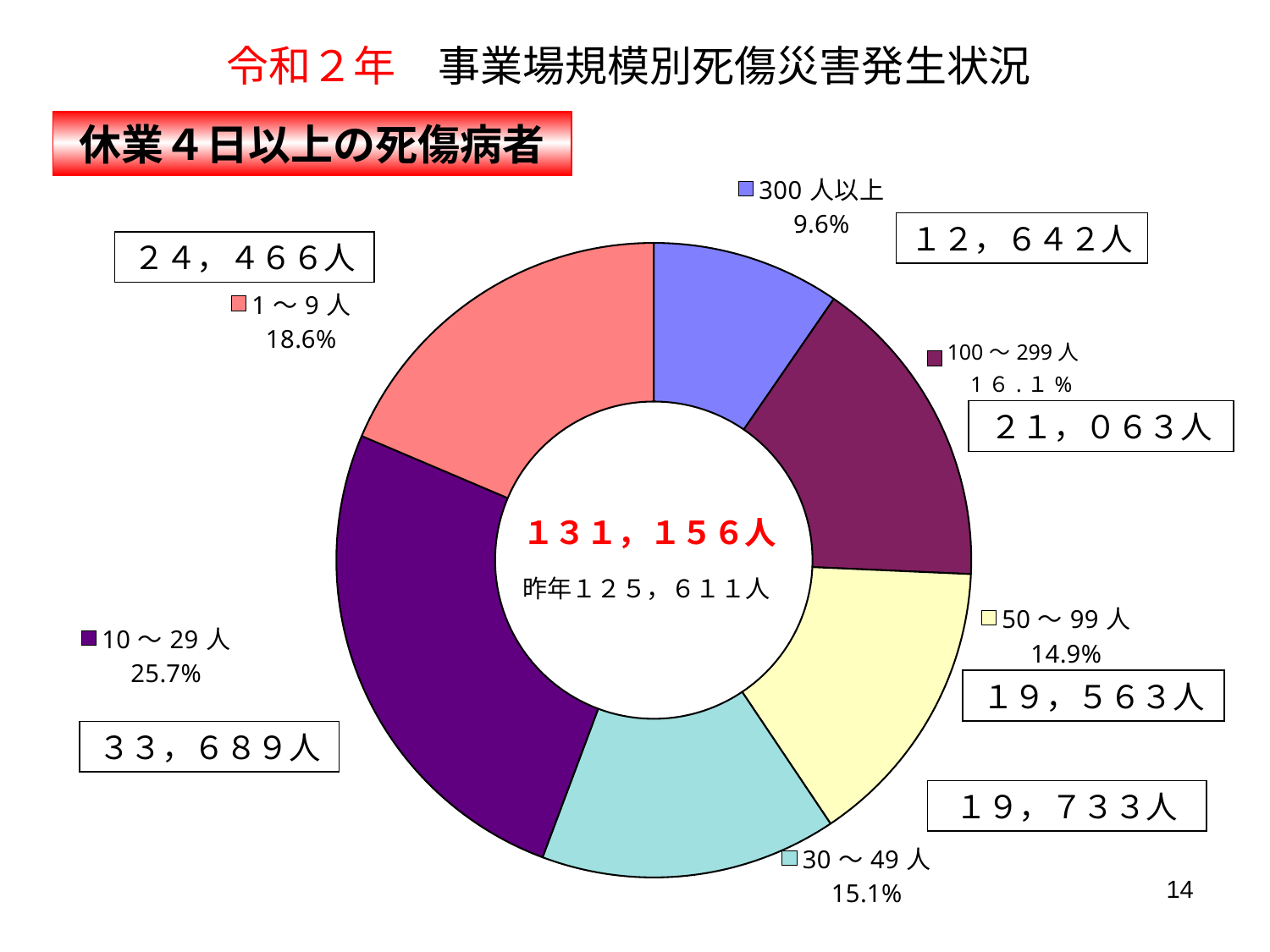
What kind of chart is shown on the slide? Donut (pie) chart What is the total number of casualties shown in the centre of the chart? 131,156人 What share of the total does the 100～299人 category account for? 16.1% What is the difference in casualties between the 30～49人 and 50～99人 categories? 170人 How many categories (establishment size groups) does the chart show? 6 Which establishment size category has the largest share of casualties? 10～29人 What share of the total does the 1～9人 category account for? 18.6% Which establishment size category has the smallest share of casualties? 300人以上 What is the number of casualties for the 10～29人 category? 33,689人 What is the number of casualties for the 50～99人 category? 19,563人 What is the number of casualties for the 300人以上 category? 12,642人 Which has more casualties, the 1～9人 category or the 100～299人 category? 1～9人